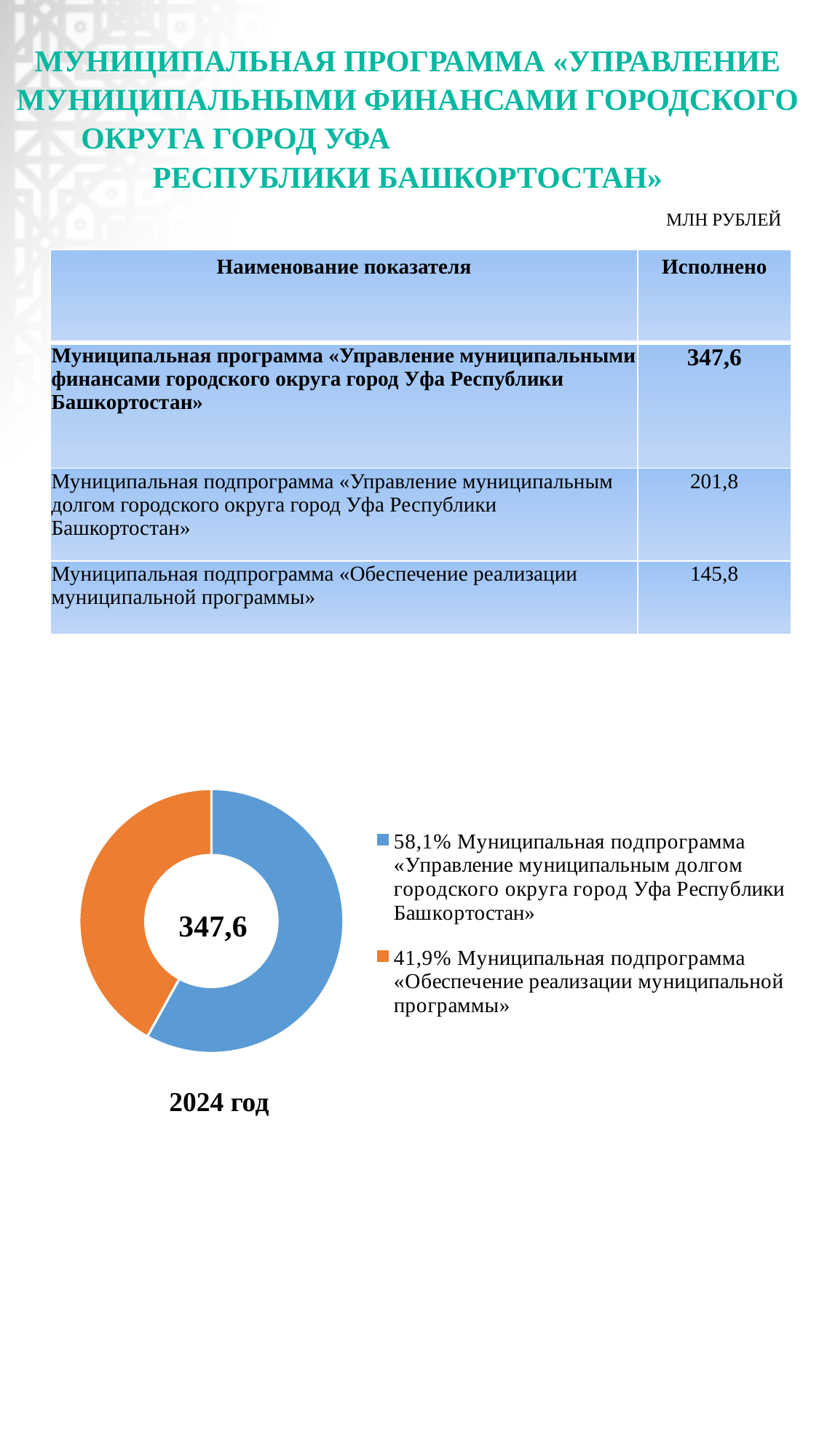
What year is labelled under the doughnut chart? 2024 год What share of the doughnut chart does the subprogram «Обеспечение реализации муниципальной программы» take? 41,9% Which slice is larger: the blue one or the orange one? The blue one Which subprogram has the smallest slice in the doughnut chart? Муниципальная подпрограмма «Обеспечение реализации муниципальной программы» What kind of chart is shown on the slide? Doughnut (pie) chart What value is printed in the centre of the doughnut chart? 347,6 What share of the doughnut chart does the subprogram «Управление муниципальным долгом городского округа город Уфа Республики Башкортостан» take? 58,1% Which subprogram has the largest slice in the doughnut chart? Муниципальная подпрограмма «Управление муниципальным долгом городского округа город Уфа Республики Башкортостан» How many slices does the doughnut chart have? 2 By how many percentage points does the share of «Управление муниципальным долгом...» exceed the share of «Обеспечение реализации муниципальной программы»? 16,2 How many entries does the legend of the doughnut chart list? 2 Is the share of the subprogram «Обеспечение реализации муниципальной программы» greater or less than 50%? less